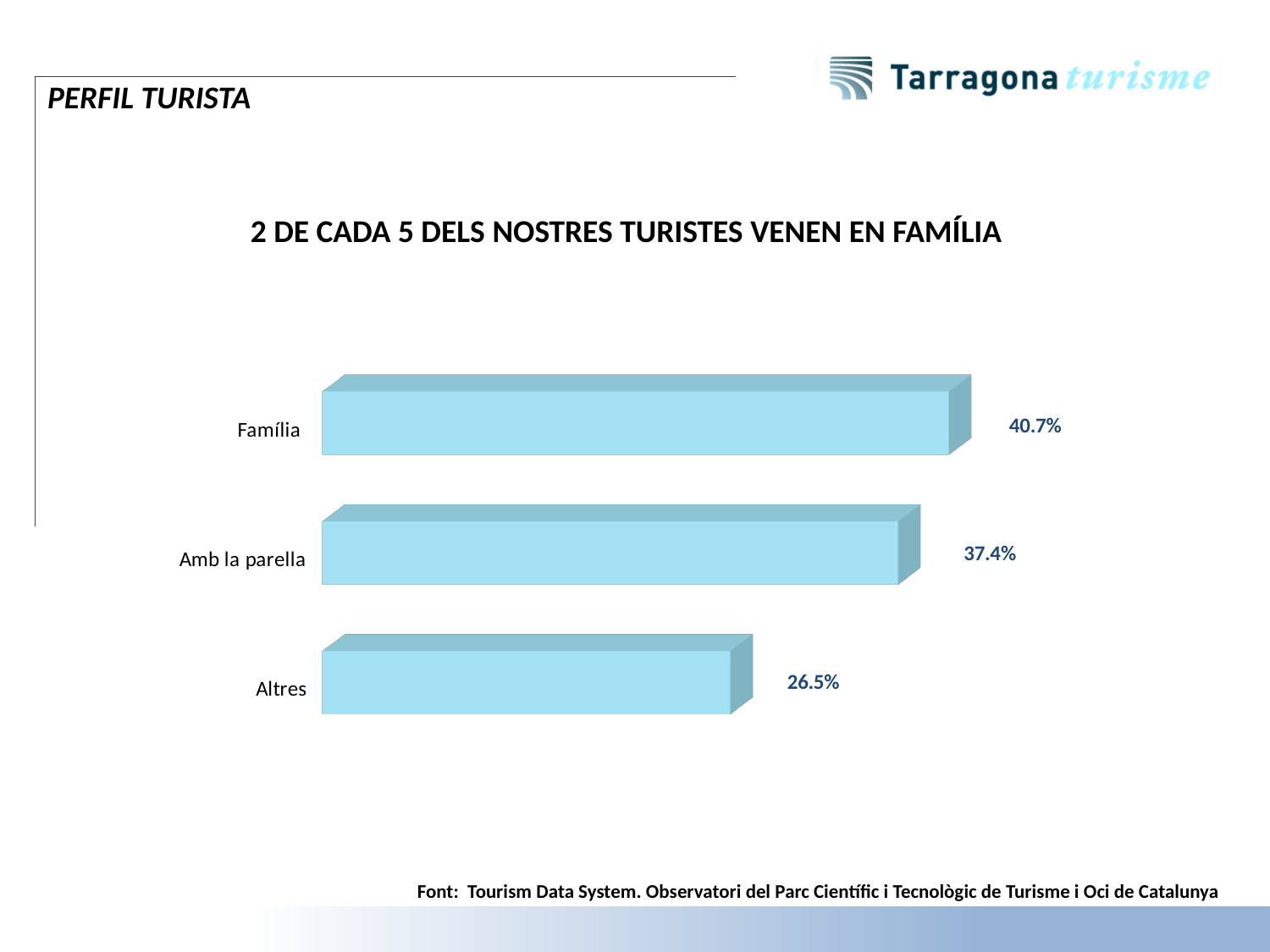
What is the value for Amb la parella? 37.4% What kind of chart is shown on the slide? Bar chart Which category has the highest value? Família Which category has the lowest value? Altres What is the value for Família? 40.7% How many categories are shown in the chart? 3 What is the difference between the values for Família and Altres? 14.2% Which is larger, the value for Amb la parella or the value for Altres? Amb la parella What is the difference between the values for Família and Amb la parella? 3.3% What is the source cited at the bottom of the slide? Tourism Data System. Observatori del Parc Científic i Tecnològic de Turisme i Oci de Catalunya What is the value for Altres? 26.5% What is the heading text above the chart? 2 DE CADA 5 DELS NOSTRES TURISTES VENEN EN FAMÍLIA